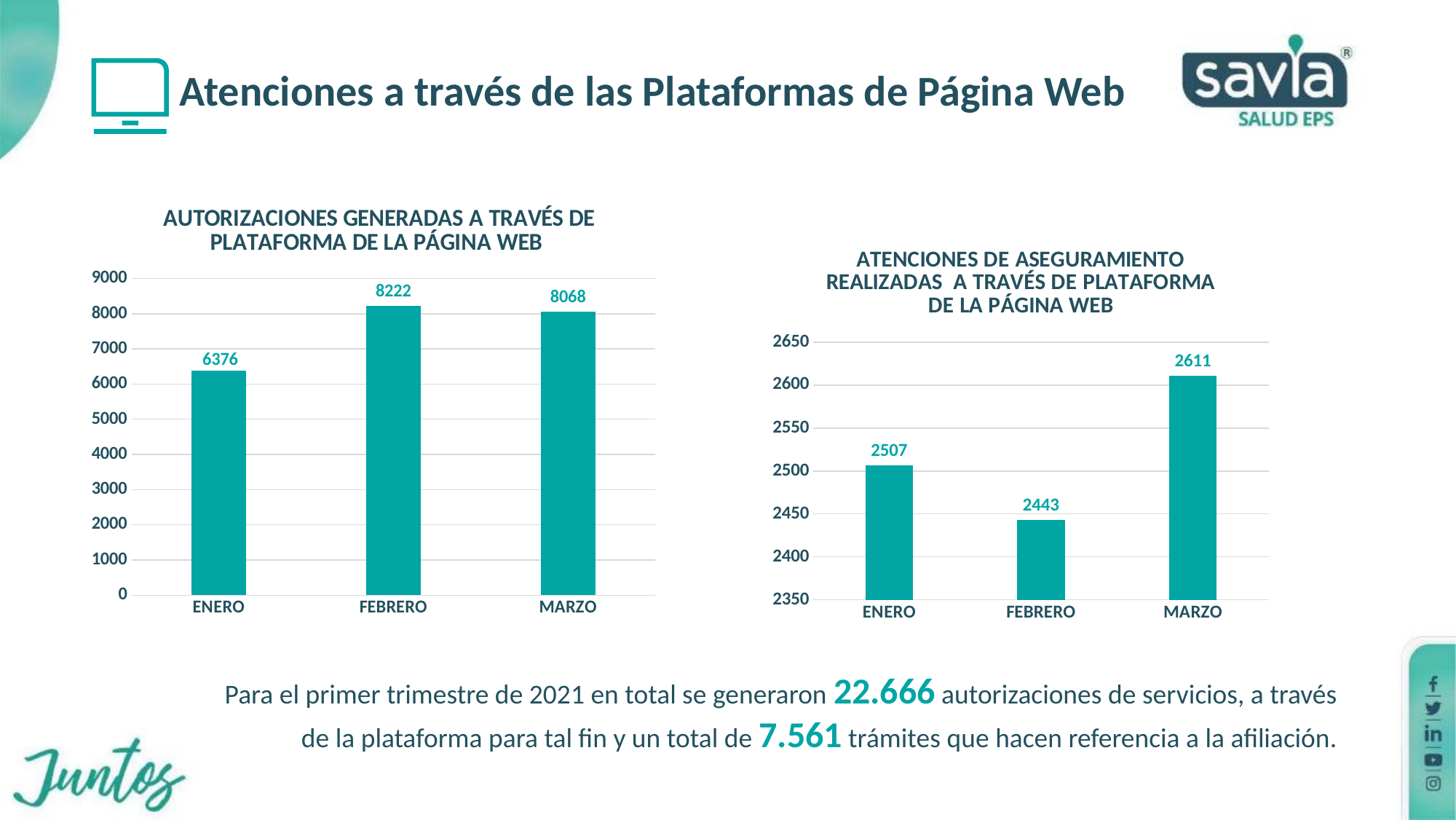
In the chart 'AUTORIZACIONES GENERADAS A TRAVÉS DE PLATAFORMA DE LA PÁGINA WEB', what is the total of the three months? 22666 In the chart 'AUTORIZACIONES GENERADAS A TRAVÉS DE PLATAFORMA DE LA PÁGINA WEB', which month has the highest value? FEBRERO In the chart 'ATENCIONES DE ASEGURAMIENTO REALIZADAS A TRAVÉS DE PLATAFORMA DE LA PÁGINA WEB', what is the difference between MARZO and FEBRERO? 168 In the chart 'ATENCIONES DE ASEGURAMIENTO REALIZADAS A TRAVÉS DE PLATAFORMA DE LA PÁGINA WEB', which is larger, ENERO or FEBRERO? ENERO In the chart 'ATENCIONES DE ASEGURAMIENTO REALIZADAS A TRAVÉS DE PLATAFORMA DE LA PÁGINA WEB', which month has the lowest value? FEBRERO In the chart 'AUTORIZACIONES GENERADAS A TRAVÉS DE PLATAFORMA DE LA PÁGINA WEB', what is the difference between FEBRERO and ENERO? 1846 In the chart 'AUTORIZACIONES GENERADAS A TRAVÉS DE PLATAFORMA DE LA PÁGINA WEB', what is the value for FEBRERO? 8222 In the chart 'ATENCIONES DE ASEGURAMIENTO REALIZADAS A TRAVÉS DE PLATAFORMA DE LA PÁGINA WEB', what is the value for MARZO? 2611 In the chart 'AUTORIZACIONES GENERADAS A TRAVÉS DE PLATAFORMA DE LA PÁGINA WEB', which month has the lowest value? ENERO What kind of chart is the chart on the left of the slide? bar chart In the chart 'AUTORIZACIONES GENERADAS A TRAVÉS DE PLATAFORMA DE LA PÁGINA WEB', how many months are shown? 3 In the chart 'ATENCIONES DE ASEGURAMIENTO REALIZADAS A TRAVÉS DE PLATAFORMA DE LA PÁGINA WEB', is the value for ENERO greater or less than 2500? greater